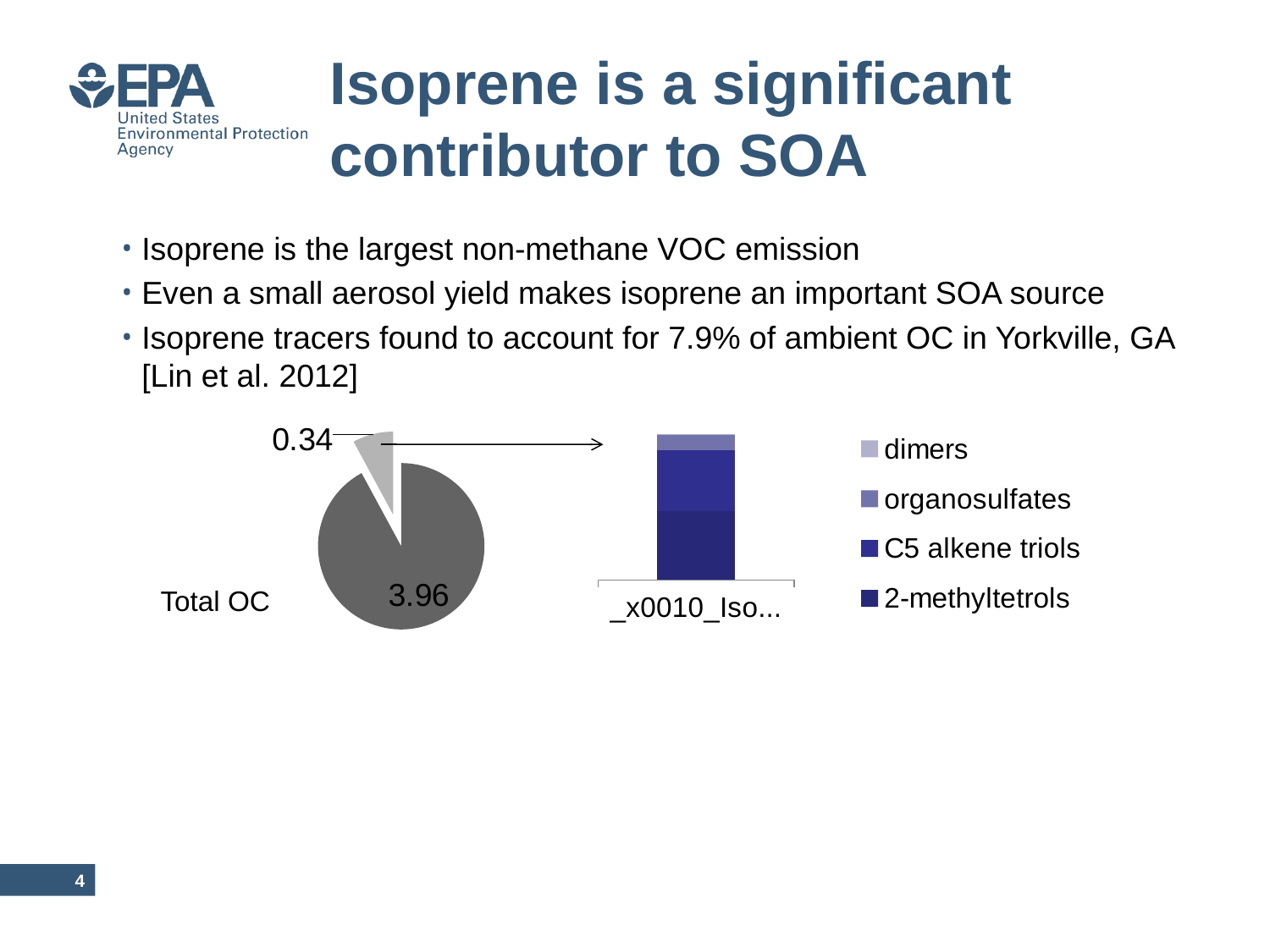
What kind of chart is the chart on the right with the legend listing dimers, organosulfates, C5 alkene triols and 2-methyltetrols? Stacked bar chart In the stacked bar chart on the right, which series is shown at the top of the legend? dimers In the stacked bar chart on the right, is the 2-methyltetrols segment larger or smaller than the dimers segment? Larger In the Total OC pie chart, what is the total of the two slice values? 4.30 What kind of chart is the chart labelled Total OC? Pie chart How many slices does the Total OC pie chart have? 2 In the Total OC pie chart, which slice is the largest? The 3.96 slice How many series does the legend of the stacked bar chart on the right list? 4 In the Total OC pie chart, what is the value of the larger (dark gray) slice? 3.96 In the Total OC pie chart, what is the value of the small exploded slice? 0.34 In the Total OC pie chart, what is the difference between the two slice values? 3.62 In the Total OC pie chart, what share of the total does the 0.34 slice represent? 7.9%